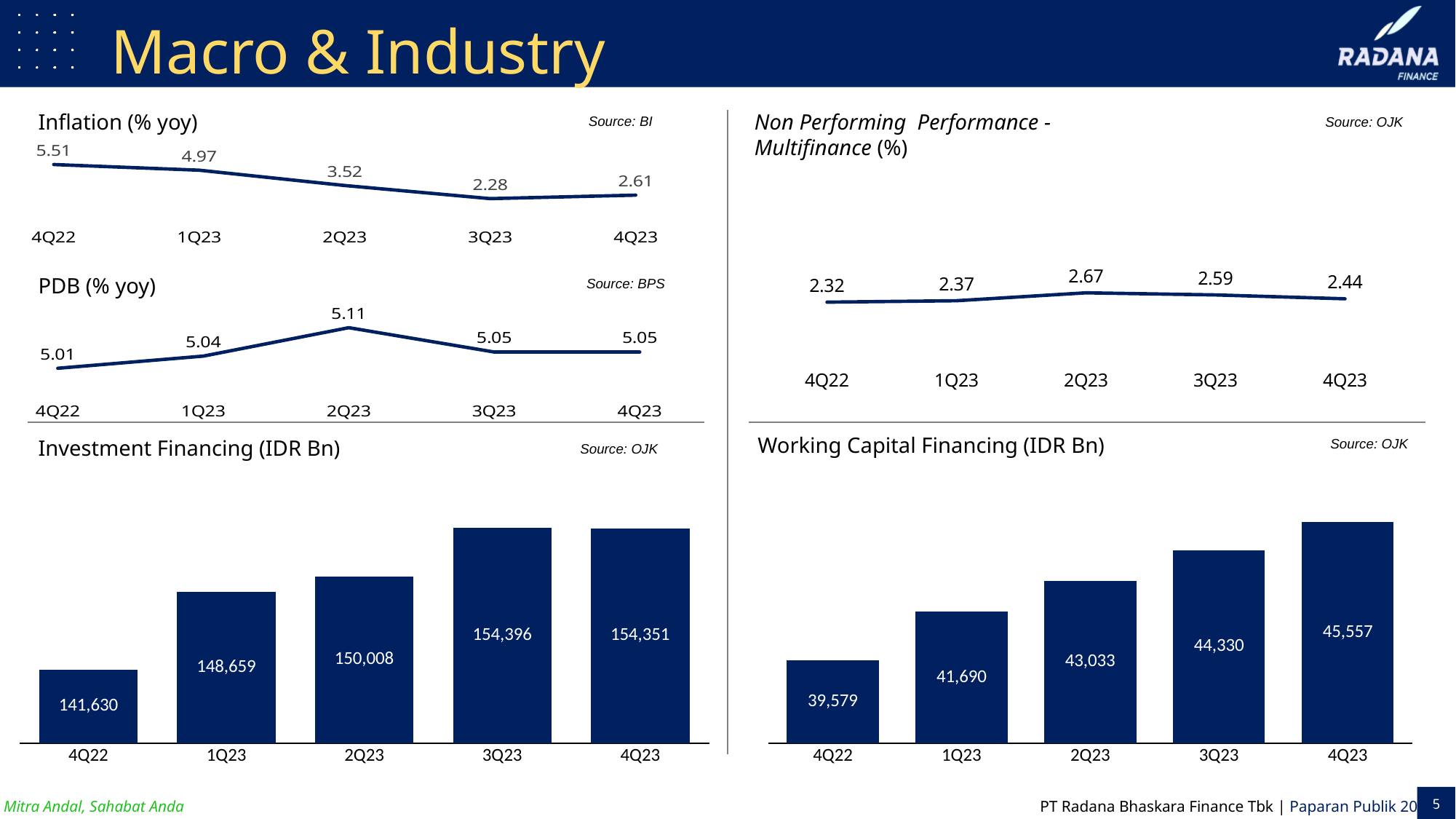
What kind of chart is the Working Capital Financing (IDR Bn) chart? bar chart In the Non Performing Performance - Multifinance (%) chart, what is the value for 3Q23? 2.59 In the Inflation (% yoy) chart, what is the value for 2Q23? 3.52 In the Working Capital Financing (IDR Bn) chart, what is the value for 4Q23? 45,557 In the Inflation (% yoy) chart, what is the difference between the 4Q22 and 4Q23 values? 2.90 In the Working Capital Financing (IDR Bn) chart, do the values rise or fall from 4Q22 to 4Q23? rise In the Investment Financing (IDR Bn) chart, what is the difference between the 3Q23 and 4Q22 values? 12,766 In the Non Performing Performance - Multifinance (%) chart, which quarter has the highest value? 2Q23 In the PDB (% yoy) chart, what is the value for 4Q22? 5.01 In the PDB (% yoy) chart, which quarter has the highest value? 2Q23 In the Inflation (% yoy) chart, which quarter has the lowest value? 3Q23 In the Investment Financing (IDR Bn) chart, what is the value for 1Q23? 148,659